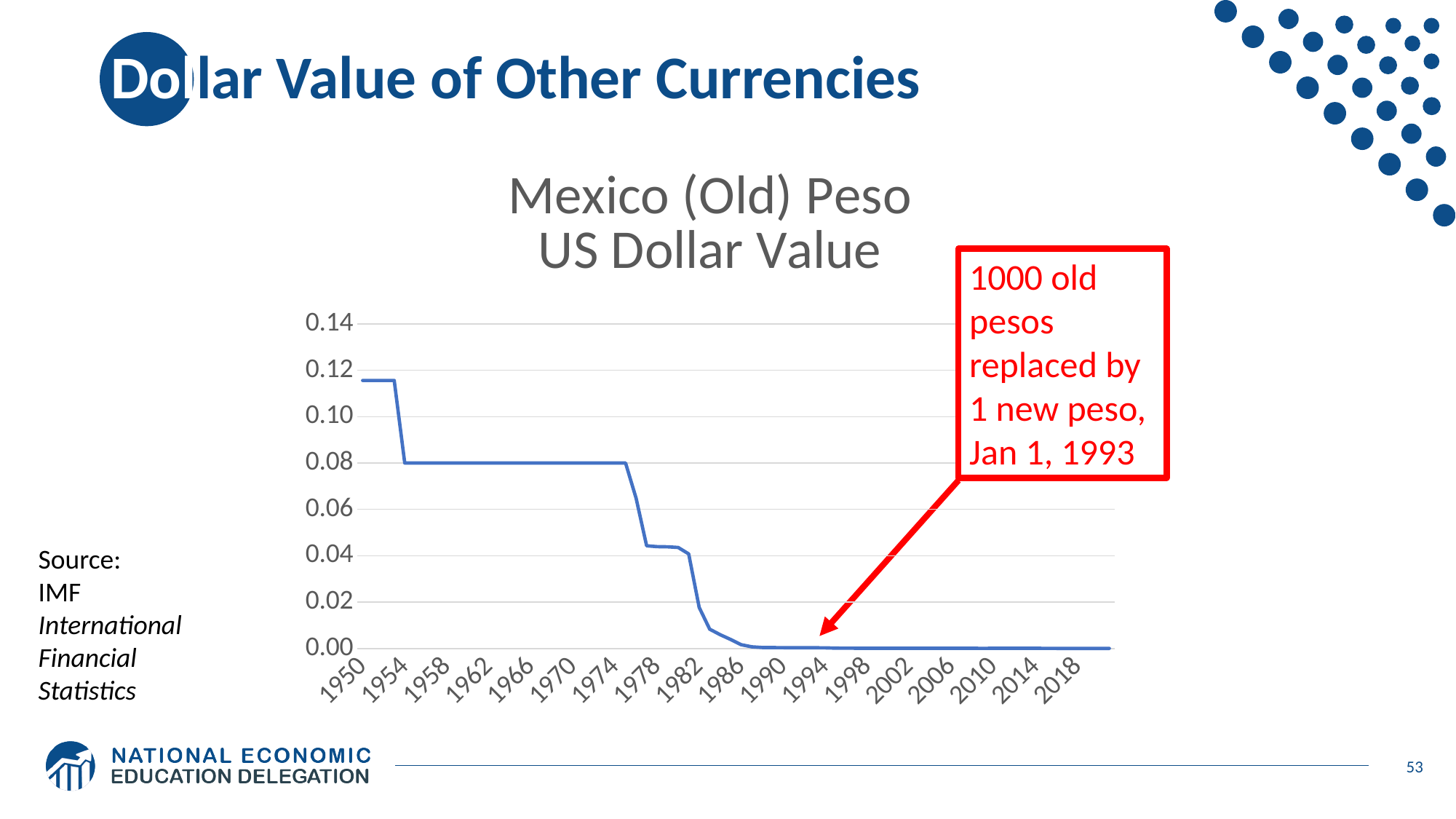
Which year has the larger value, 1950 or 1970? 1950 Is the value for 2010 greater or less than 0.02? less Is the value for 1950 greater or less than 0.10? greater Is the value for 1978 greater or less than 0.06? less What kind of chart is shown on the slide? line chart How many year labels are shown on the x axis? 18 Does the US dollar value of the Mexican old peso rise or fall from 1950 to 2018? fall What is the highest value shown on the y axis? 0.14 Which year has the larger value, 1978 or 1986? 1978 What is the title of the chart? Mexico (Old) Peso US Dollar Value